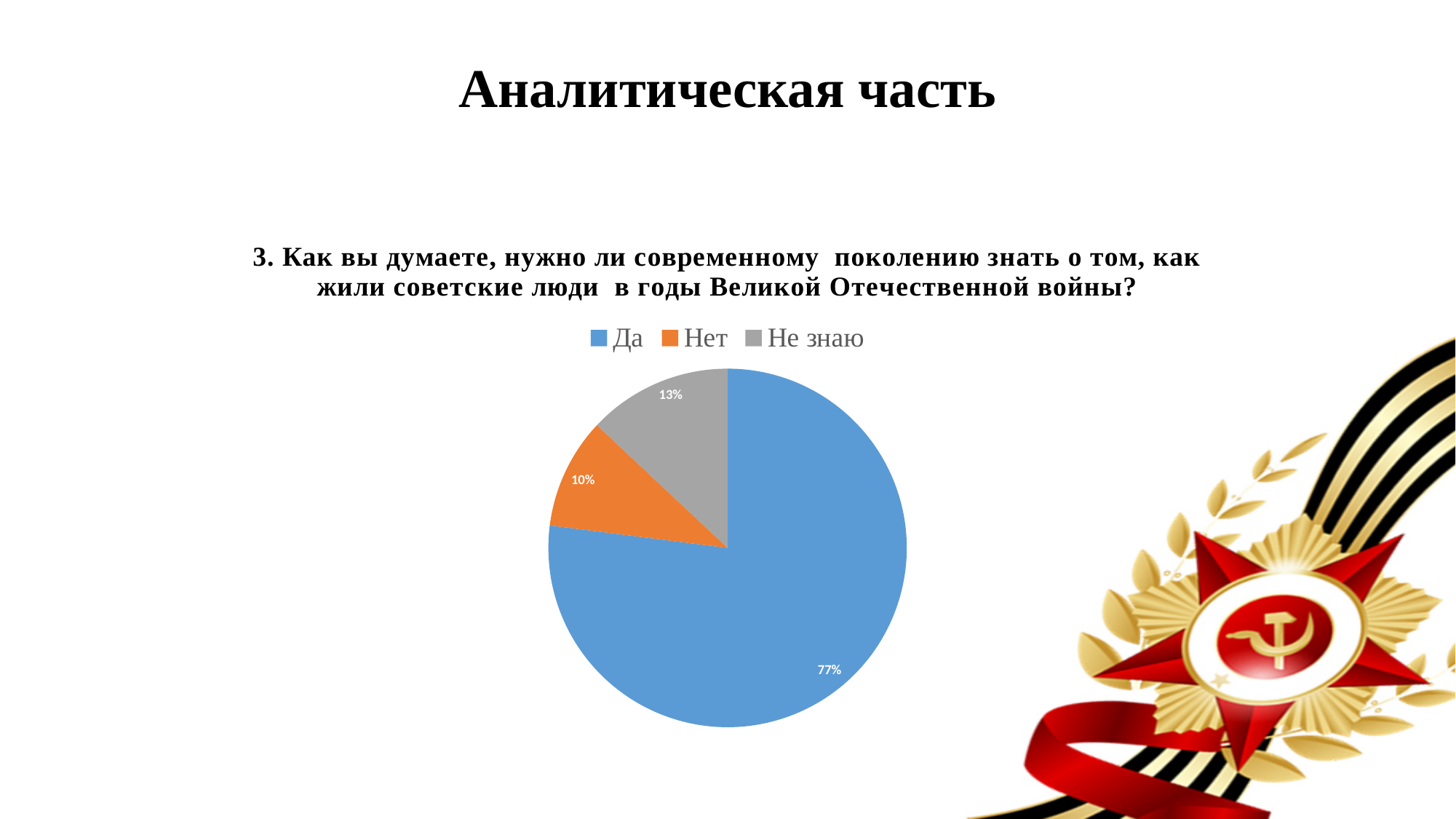
How many slices does the pie chart have? 3 What colour is the slice for "Нет"? orange Which is larger, the slice for "Нет" or the slice for "Не знаю"? Не знаю What is the difference in percentage points between "Да" and "Не знаю"? 64 What is the difference in percentage points between "Не знаю" and "Нет"? 3 Which category has the smallest slice of the pie? Нет Which category has the largest slice of the pie? Да What share of the pie does "Не знаю" have? 13% What share of the pie does "Нет" have? 10% What kind of chart is shown on the slide? pie chart How many entries does the legend list? 3 What share of the pie does "Да" have? 77%